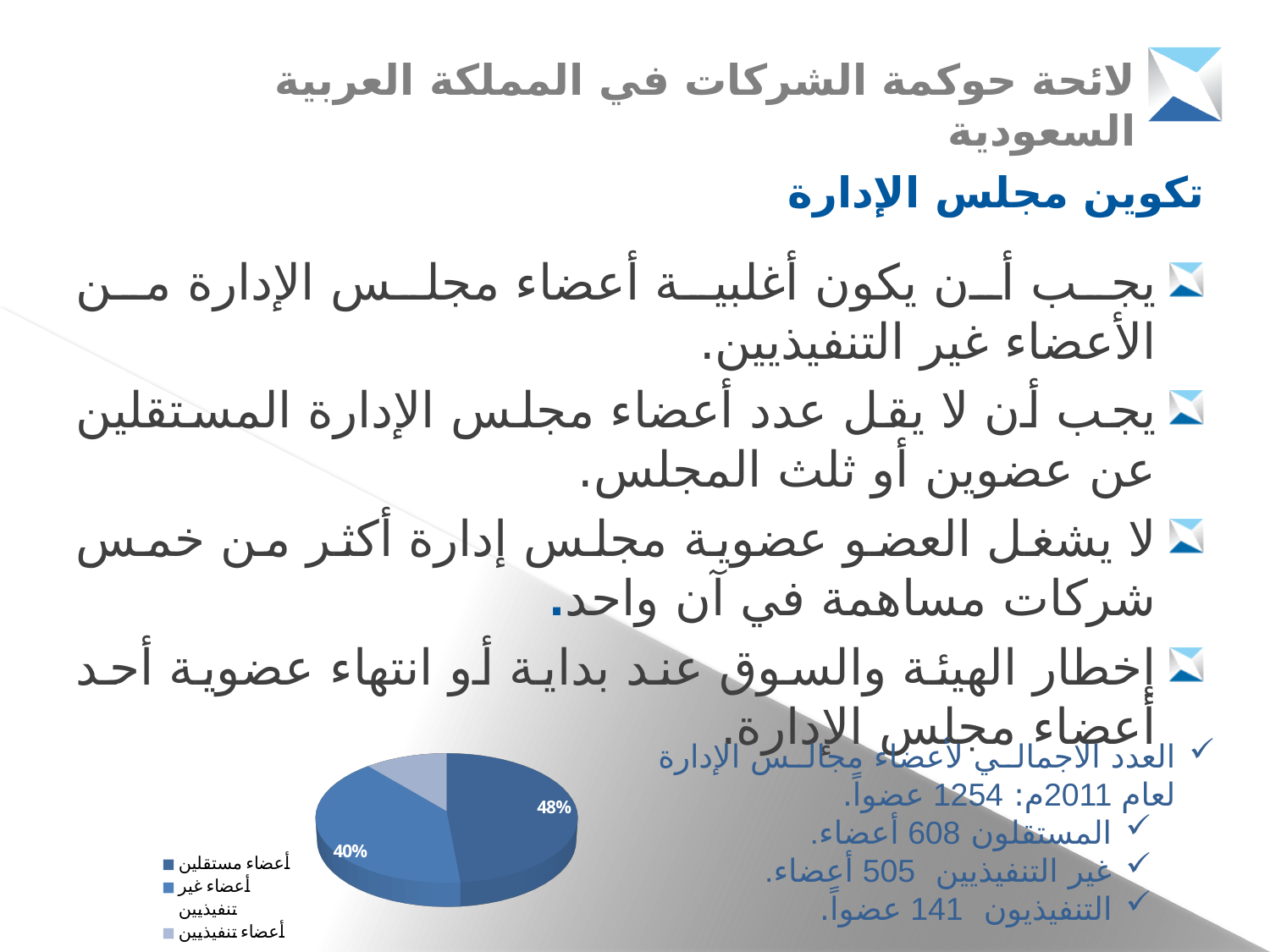
How many slices does the pie chart have? 3 Which category has the largest slice in the pie chart? أعضاء مستقلين What is the difference in percentage points between the أعضاء مستقلين slice and the أعضاء غير تنفيذيين slice? 8 Which legend entry is listed first in the pie chart's legend? أعضاء مستقلين What percentage is shown for أعضاء مستقلين in the pie chart? 48% What kind of chart is shown at the bottom left of the slide? pie chart Which category has the smallest slice in the pie chart? أعضاء تنفيذيين What percentage is shown for أعضاء غير تنفيذيين in the pie chart? 40% What share of the pie does the أعضاء مستقلين slice represent? 48% Which legend entry is shown with the lightest blue colour in the pie chart? أعضاء تنفيذيين How many entries does the legend of the pie chart list? 3 Which slice is larger in the pie chart, أعضاء مستقلين or أعضاء غير تنفيذيين? أعضاء مستقلين